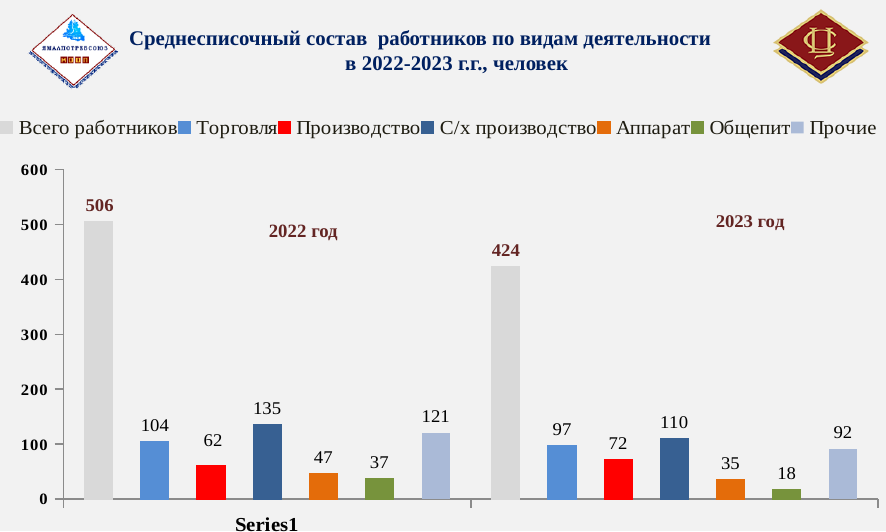
What is the value for Всего работников in 2022 год? 506 What is the value for Торговля in 2023 год? 97 What is the value for С/х производство in 2022 год? 135 Which series has the lowest value in 2022 год? Общепит Excluding Всего работников, which series has the highest value in 2023 год? С/х производство What is the value for Общепит in 2023 год? 18 How many series does the legend list? 7 Is the value for Прочие in 2023 год greater or less than 100? less Which is larger: Производство in 2022 год or Производство in 2023 год? Производство in 2023 год What colour represents Аппарат in the legend? orange What kind of chart is shown on the slide? bar chart What is the difference between Всего работников in 2022 год and in 2023 год? 82